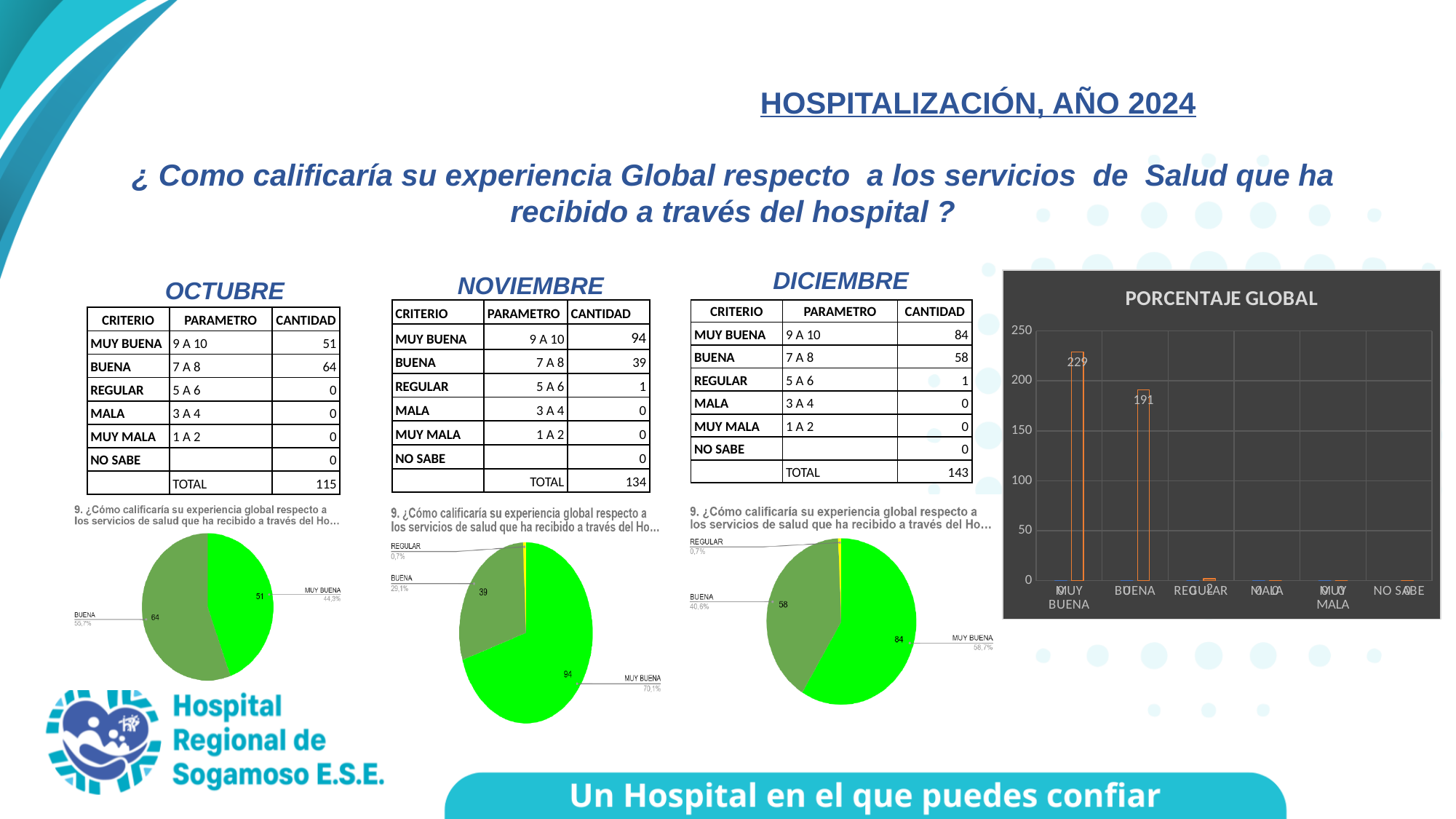
In the PORCENTAJE GLOBAL bar chart, what is the difference between the MUY BUENA and BUENA values? 38 What kind of chart is the PORCENTAJE GLOBAL chart? Bar chart In the DICIEMBRE pie chart, which is larger, MUY BUENA or BUENA? MUY BUENA In the DICIEMBRE pie chart, what is the value for BUENA? 58 In the PORCENTAJE GLOBAL bar chart, how many categories are shown on the x axis? 6 In the PORCENTAJE GLOBAL bar chart, what is the value for BUENA? 191 In the OCTUBRE pie chart, what is the value for MUY BUENA? 51 In the PORCENTAJE GLOBAL bar chart, what is the value for MUY BUENA? 229 In the PORCENTAJE GLOBAL bar chart, which category has the highest value? MUY BUENA In the NOVIEMBRE pie chart, what share does MUY BUENA have? 70,1% In the PORCENTAJE GLOBAL bar chart, is the value for BUENA greater or less than 150? greater In the OCTUBRE pie chart, what share does BUENA have? 55,7%